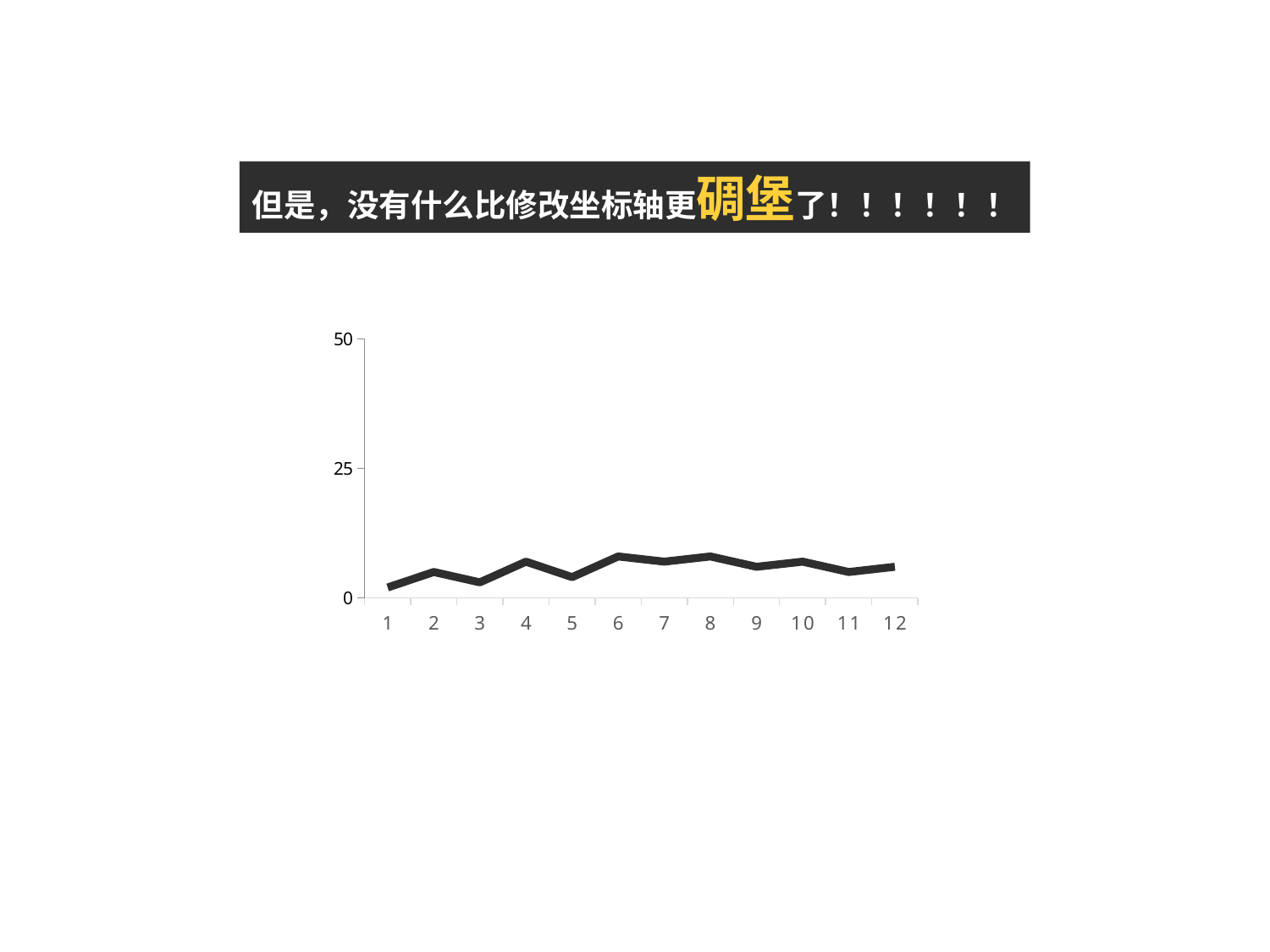
What kind of chart is shown on the slide? line chart How many data points are plotted along the x axis? 12 Which is larger, the value at x = 3 or the value at x = 4? x = 4 Is the value at x = 1 greater or less than 25? less Is the value at x = 12 greater or less than 25? less Which is larger, the value at x = 1 or the value at x = 6? x = 6 What are the tick labels shown on the y axis? 0, 25, 50 Is the value at x = 6 greater or less than 25? less What is the highest value labelled on the y axis? 50 Which is larger, the value at x = 5 or the value at x = 8? x = 8